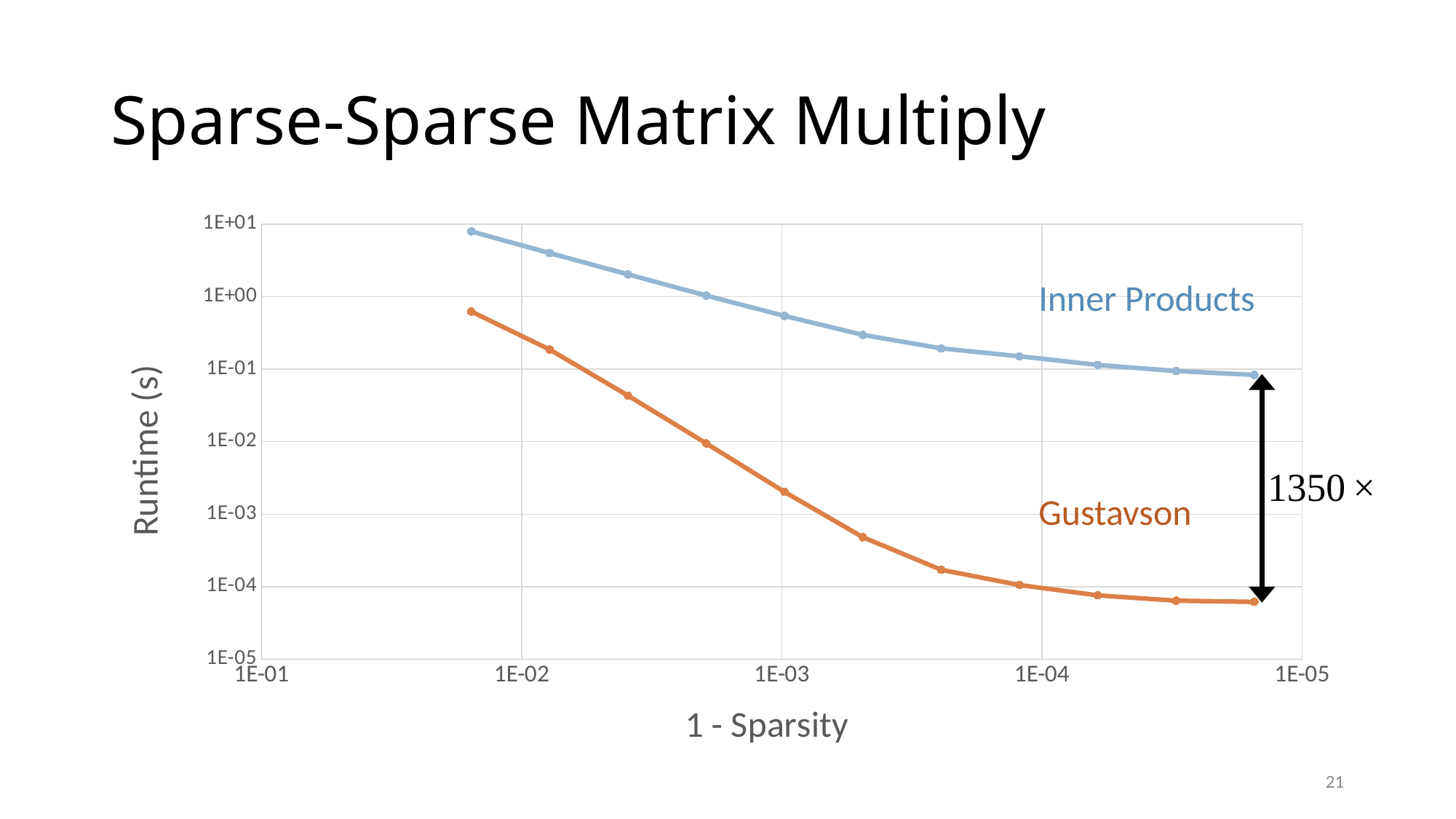
Which series has the higher runtime across the whole chart, Inner Products or Gustavson? Inner Products Is the Inner Products runtime at 1 - Sparsity = 1E-03 greater or less than 1E-01 s? greater What speedup factor is annotated between the two series at the right end of the chart? 1350 × Is the Gustavson runtime at 1 - Sparsity = 1E-03 greater or less than 1E-02 s? less Is the Inner Products runtime at 1 - Sparsity = 1E-04 greater or less than 1E-01 s? greater Does the runtime for Gustavson rise or fall as 1 - Sparsity moves from 1E-01 toward 1E-05 along the x axis? fall What kind of chart is shown on the slide? line chart How many series are plotted on the chart? 2 Which series has the lowest runtime at 1 - Sparsity = 1E-05? Gustavson Does the runtime for Inner Products rise or fall as 1 - Sparsity moves from 1E-01 toward 1E-05 along the x axis? fall How many data points are plotted for the Gustavson series? 11